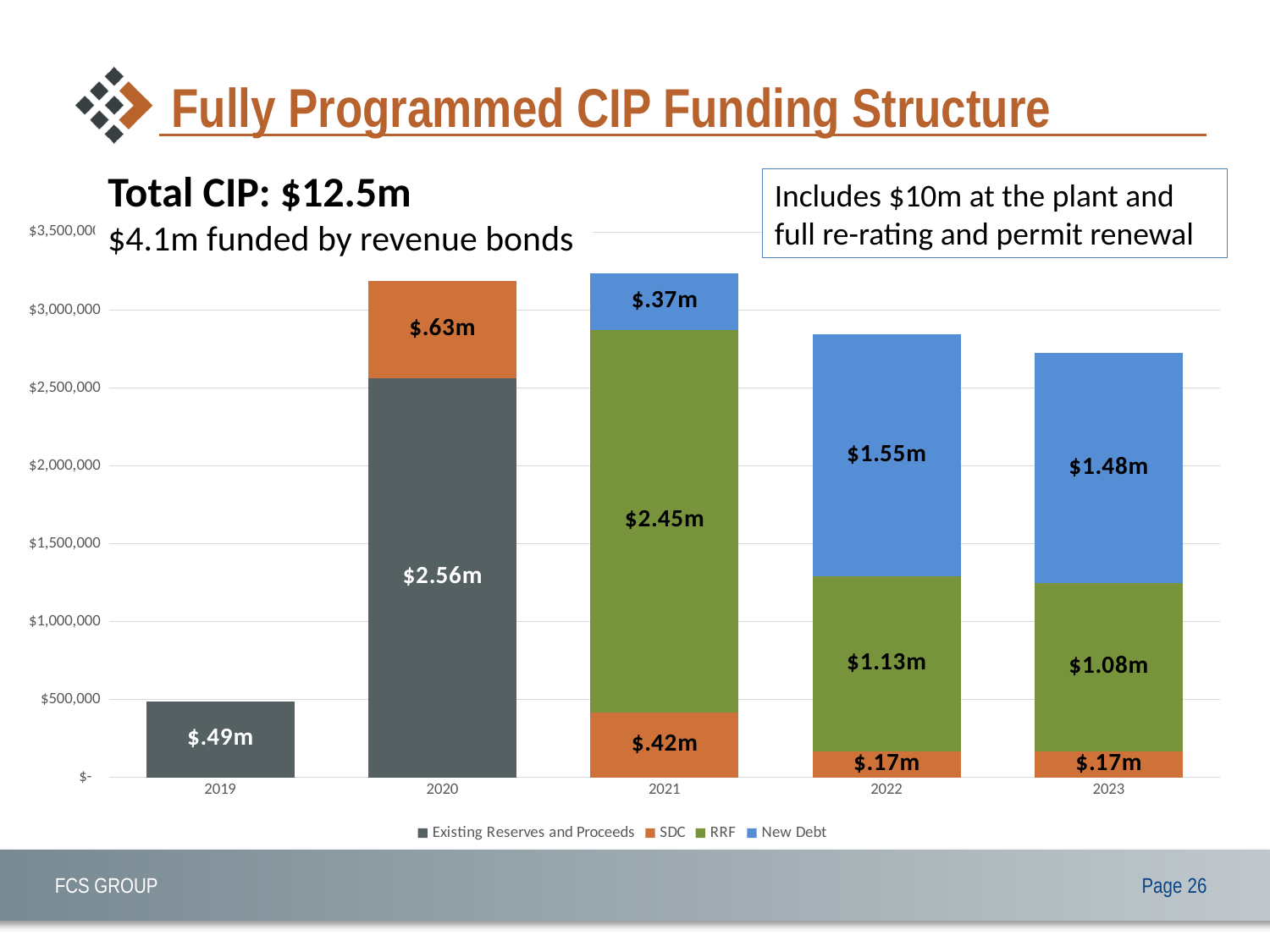
What is the difference between the RRF values for 2022 and 2023? $.05m Which year has the highest New Debt value? 2022 Which year has the lowest RRF value among the years where RRF is shown? 2023 Is the total of the 2022 bar greater or less than $2,500,000? greater What is the total of the stacked bar for 2021? $3.24m What is the RRF value for 2021? $2.45m What is the New Debt value for 2023? $1.48m How many years are shown on the x axis? 5 What is the value of Existing Reserves and Proceeds for 2020? $2.56m Is the SDC value for 2020 larger or smaller than the SDC value for 2021? larger What is the SDC value for 2022? $.17m How many series does the legend list? 4